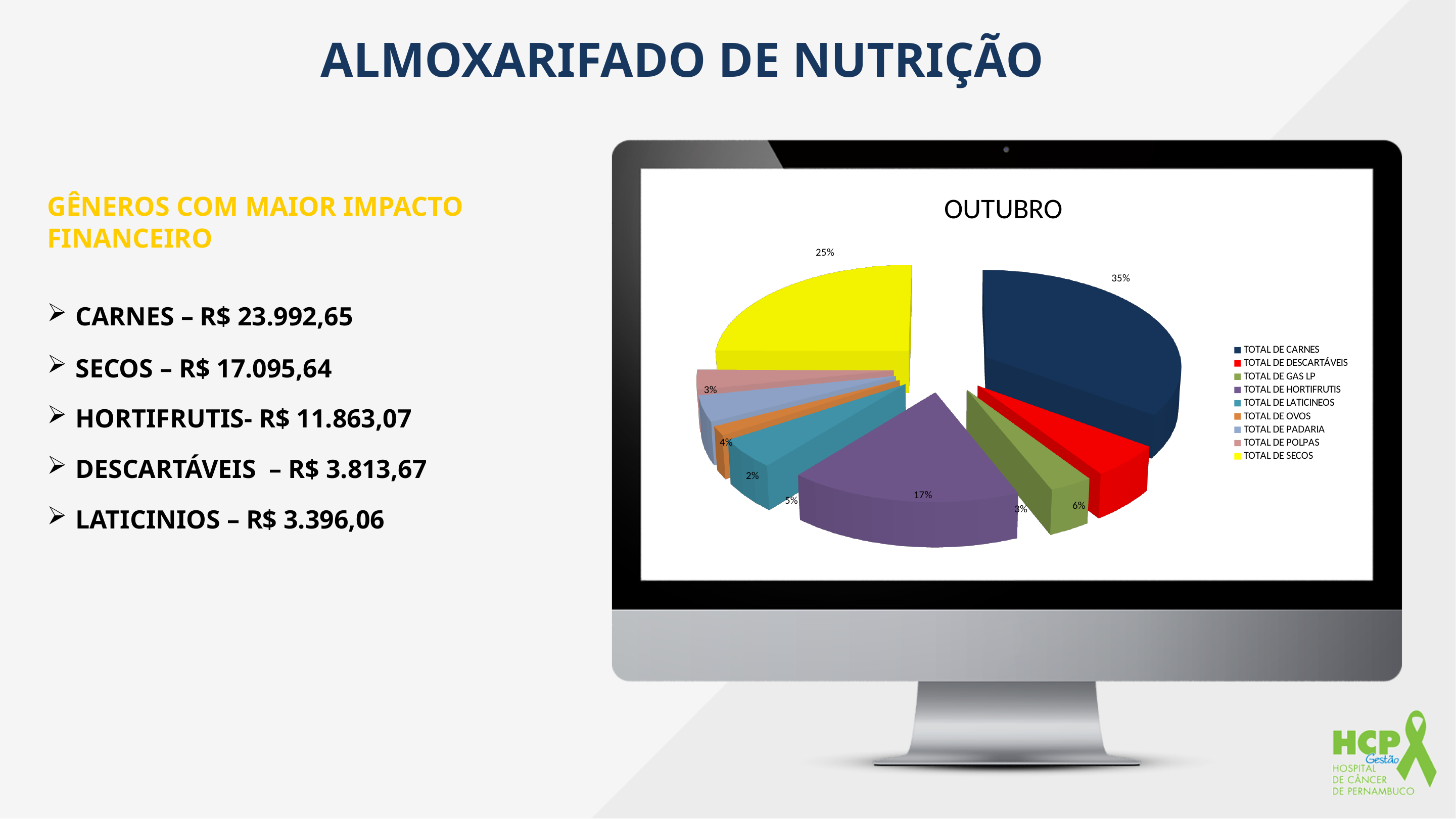
Which category has the largest slice of the pie? TOTAL DE CARNES What share of the pie does TOTAL DE DESCARTÁVEIS represent? 6% By how many percentage points does TOTAL DE CARNES exceed TOTAL DE SECOS? 10 What share of the pie does TOTAL DE SECOS represent? 25% Which slice is larger, TOTAL DE CARNES or TOTAL DE SECOS? TOTAL DE CARNES What share of the pie does TOTAL DE CARNES represent? 35% How many categories does the legend of the pie chart list? 9 Which category has the smallest slice of the pie? TOTAL DE OVOS Which slice is larger, TOTAL DE HORTIFRUTIS or TOTAL DE DESCARTÁVEIS? TOTAL DE HORTIFRUTIS What kind of chart is shown on the slide? Pie chart What is the title of the chart? OUTUBRO